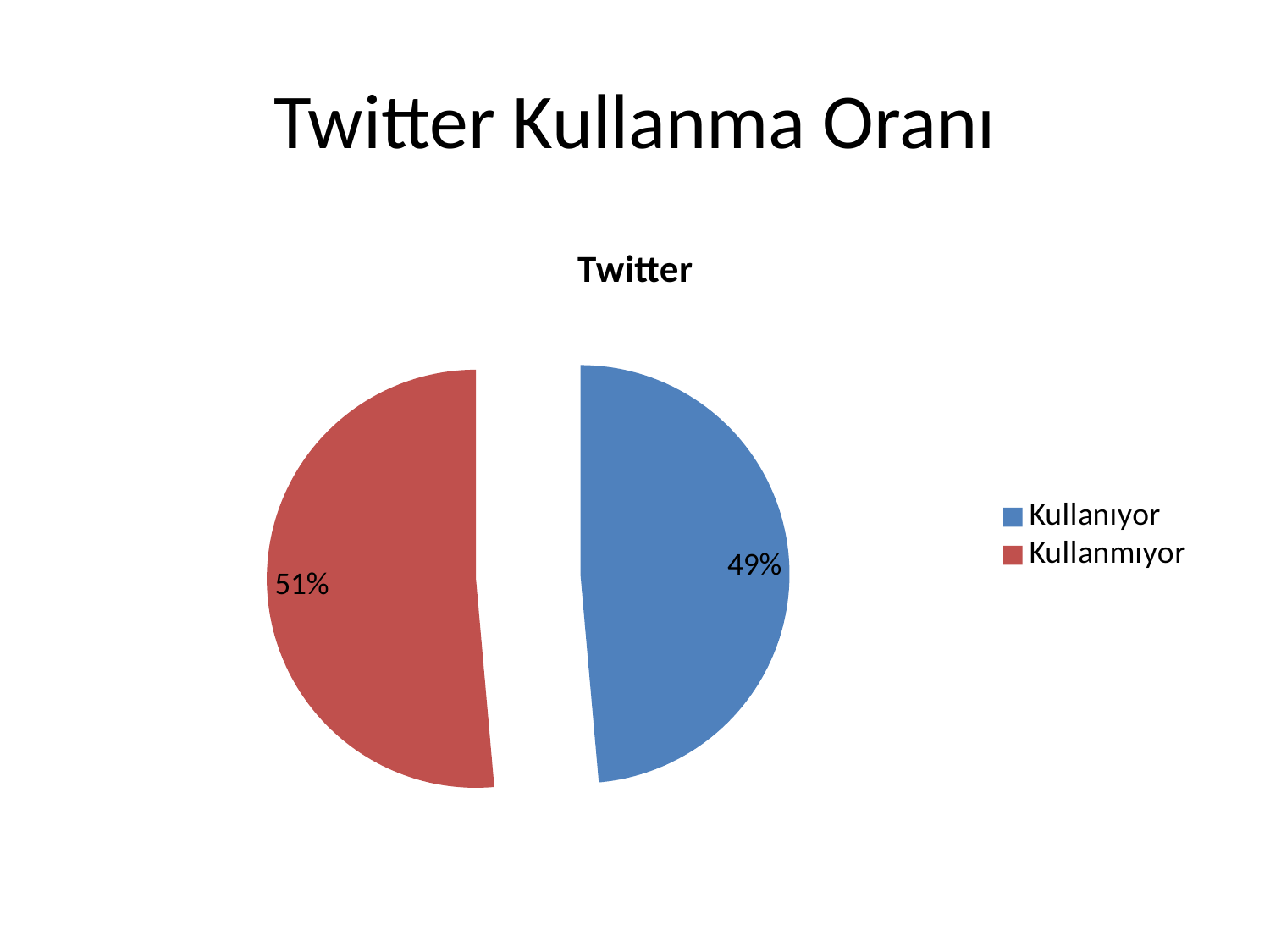
What kind of chart is shown on the slide? Pie chart How many slices does the pie chart have? 2 What share of the pie does Kullanmıyor represent? 51% What is the title of the chart? Twitter What is the value shown for the Kullanıyor slice? 49% Which category has the smallest slice of the pie? Kullanıyor Which is larger, the Kullanıyor slice or the Kullanmıyor slice? Kullanmıyor Which colour represents Kullanıyor in the legend? Blue What share of the pie does Kullanıyor represent? 49% What is the value shown for the Kullanmıyor slice? 51% What is the difference between the Kullanmıyor and Kullanıyor shares? 2% Which category has the largest slice of the pie? Kullanmıyor